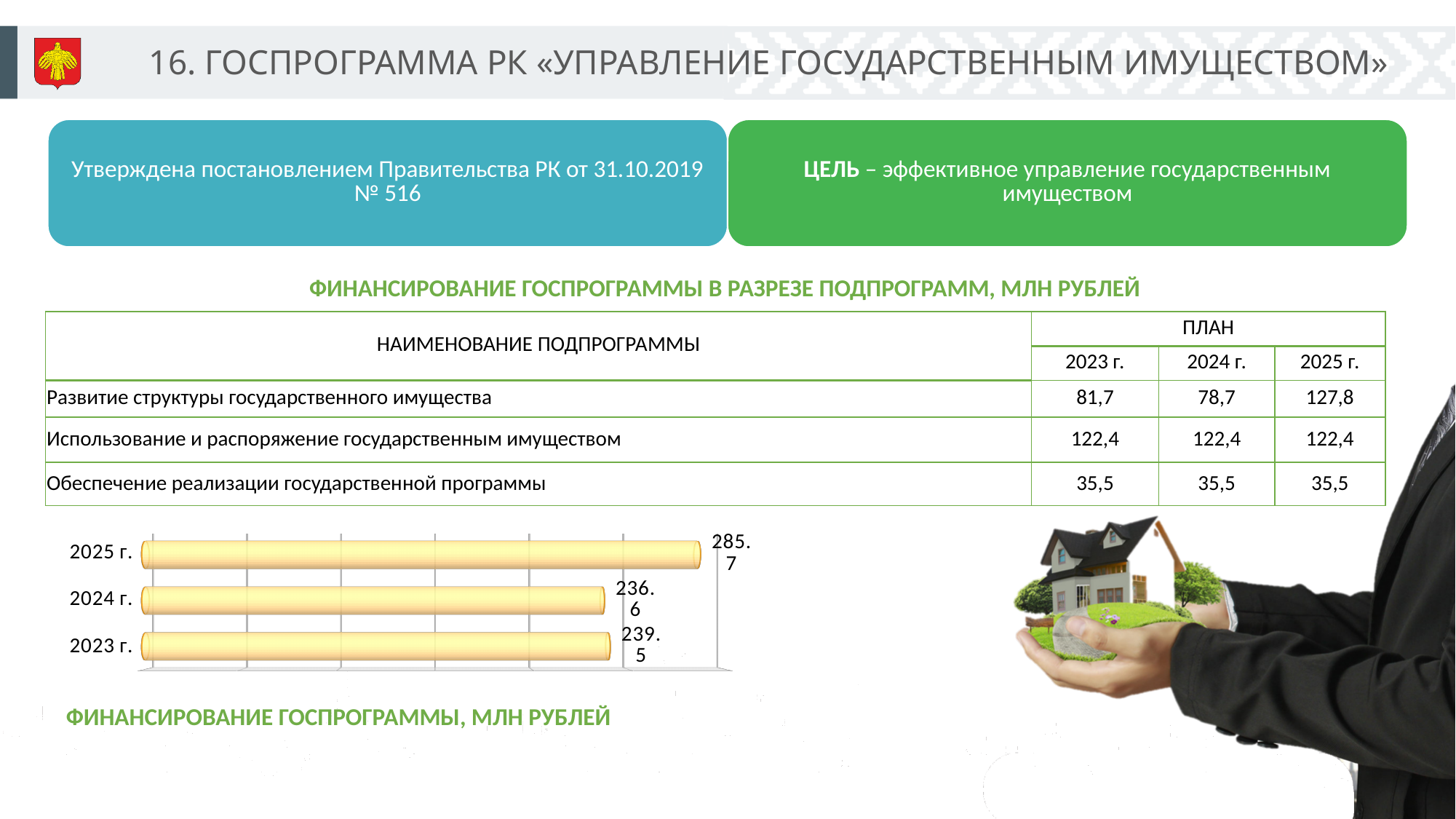
Which is larger in the bar chart, the value for 2023 г. or the value for 2024 г.? 2023 г. What is the value for 2023 г. in the bar chart? 239.5 What is the value for 2025 г. in the bar chart? 285.7 Which year has the highest value in the bar chart? 2025 г. What is the difference between the values for 2025 г. and 2023 г. in the bar chart? 46.2 What is the title of the bar chart? ФИНАНСИРОВАНИЕ ГОСПРОГРАММЫ, МЛН РУБЛЕЙ How many bars are shown in the bar chart? 3 Does the value rise or fall from 2024 г. to 2025 г. in the bar chart? Rise What is the value for 2024 г. in the bar chart? 236.6 What is the difference between the values for 2023 г. and 2024 г. in the bar chart? 2.9 What kind of chart is shown on the slide? Bar chart Which year has the lowest value in the bar chart? 2024 г.